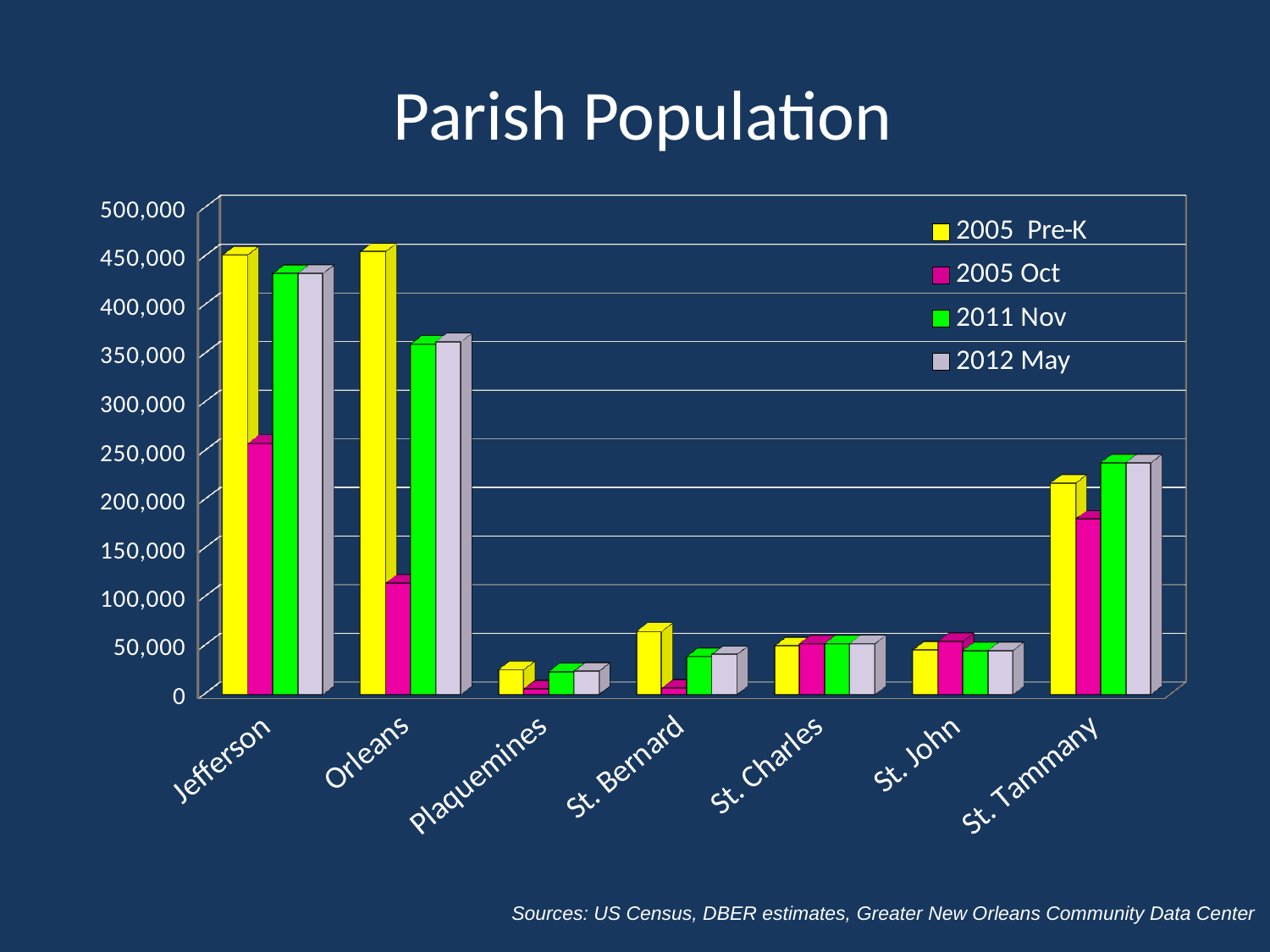
Is the 2012 May value for St. Tammany greater or less than 200,000? greater Which is larger, the 2011 Nov value for Orleans or for St. Tammany? Orleans Which parish has the lowest 2005 Pre-K value? Plaquemines Is the 2005 Oct value for Orleans greater or less than 150,000? less What kind of chart is shown on the slide? Bar chart Which parish has the highest 2005 Oct value? Jefferson Is the 2005 Pre-K value for Jefferson greater or less than 400,000? greater How many series does the legend list? 4 How many parishes are shown on the x axis? 7 What colour represents the 2005 Oct series in the legend? Magenta What is the title of the chart? Parish Population Which parish has the highest 2011 Nov value? Jefferson